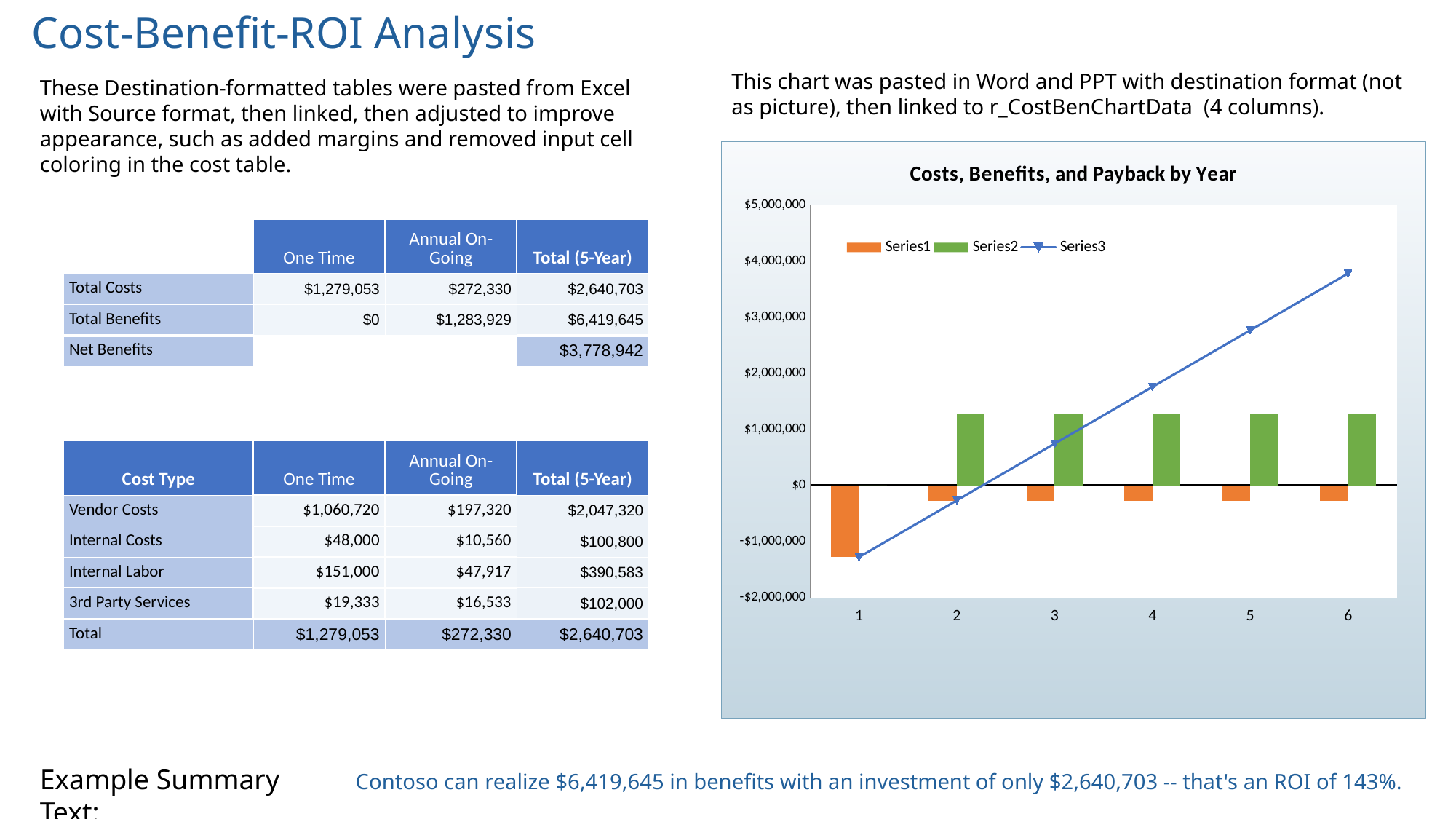
What kind of chart is shown on the slide? A combined bar and line chart Is the value for Series1 at category 1 greater or less than -$1,000,000? less Does Series3 rise or fall as the x axis goes from 1 to 6? Rises How many series does the chart legend list? 3 How many categories are shown on the x axis of the chart? 6 What is the title of the chart? Costs, Benefits, and Payback by Year At which x-axis category does Series3 have its lowest value? 1 At which x-axis category does Series3 reach its highest value? 6 Is the value for Series3 at category 6 greater or less than $3,000,000? greater At which x-axis category does Series1 have its lowest value? 1 Is the value for Series2 at category 2 greater or less than $1,000,000? greater Which series in the chart is drawn as a line with markers? Series3